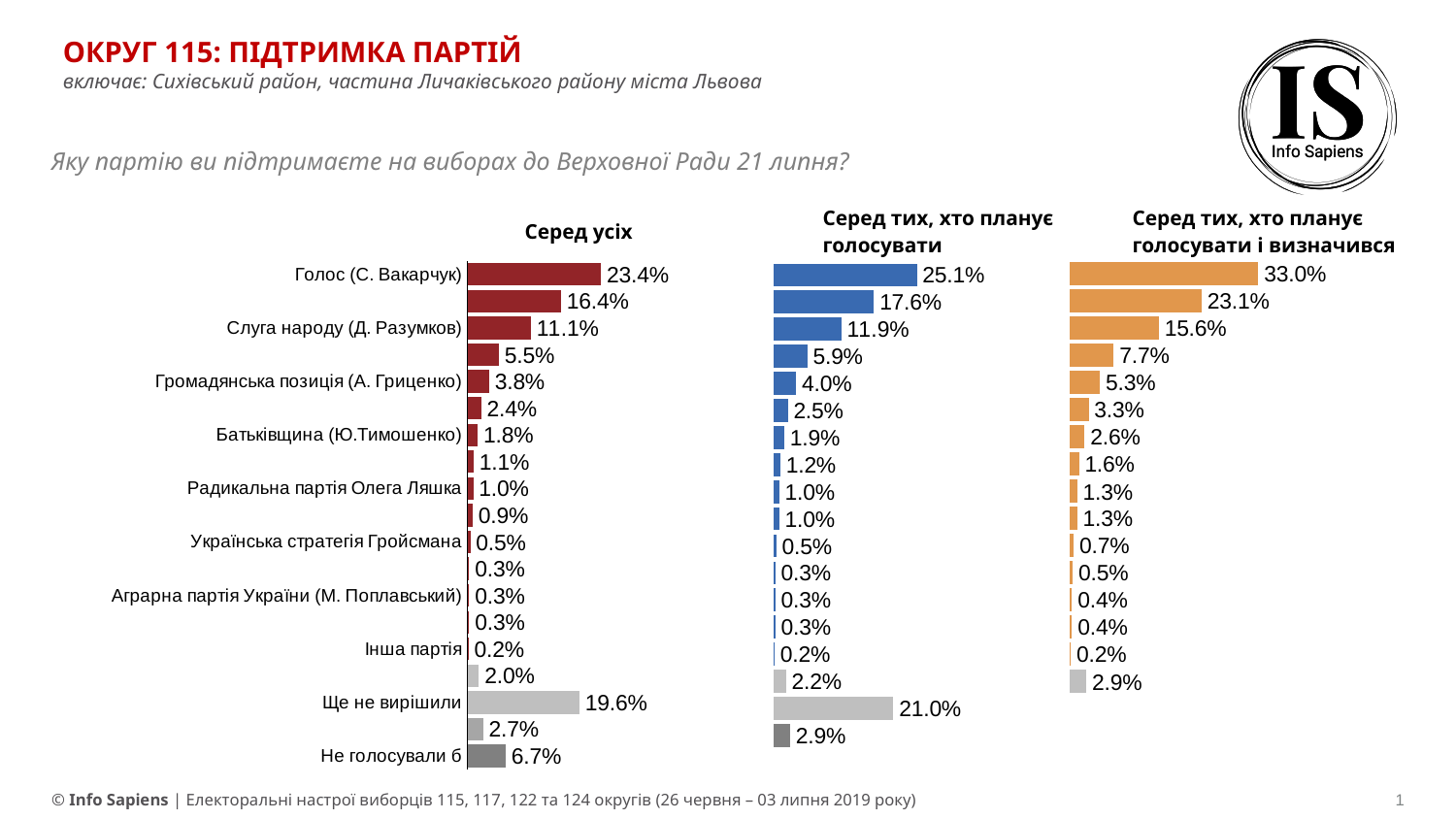
In the chart titled "Серед тих, хто планує голосувати", what is the value for Ще не вирішили? 21.0% In the chart titled "Серед усіх", what is the value for Не голосували б? 6.7% In the chart titled "Серед усіх", what is the value for Ще не вирішили? 19.6% In the chart titled "Серед тих, хто планує голосувати і визначився", which party has the highest value? Голос (С. Вакарчук) In the chart titled "Серед тих, хто планує голосувати і визначився", what is the value for Громадянська позиція (А. Гриценко)? 5.3% In the chart titled "Серед тих, хто планує голосувати і визначився", what is the value for Голос (С. Вакарчук)? 33.0% In the chart titled "Серед тих, хто планує голосувати і визначився", what is the difference between the values for Голос (С. Вакарчук) and Слуга народу (Д. Разумков)? 17.4 percentage points In the chart titled "Серед тих, хто планує голосувати", which is larger: the value for Батьківщина (Ю.Тимошенко) or for Радикальна партія Олега Ляшка? Батьківщина (Ю.Тимошенко) In the chart titled "Серед тих, хто планує голосувати", what is the value for Слуга народу (Д. Разумков)? 11.9% In the chart titled "Серед усіх", what is the value for Голос (С. Вакарчук)? 23.4% In the chart titled "Серед усіх", what is the difference between the values for Голос (С. Вакарчук) and Слуга народу (Д. Разумков)? 12.3 percentage points What kind of chart is used on this slide? Bar chart